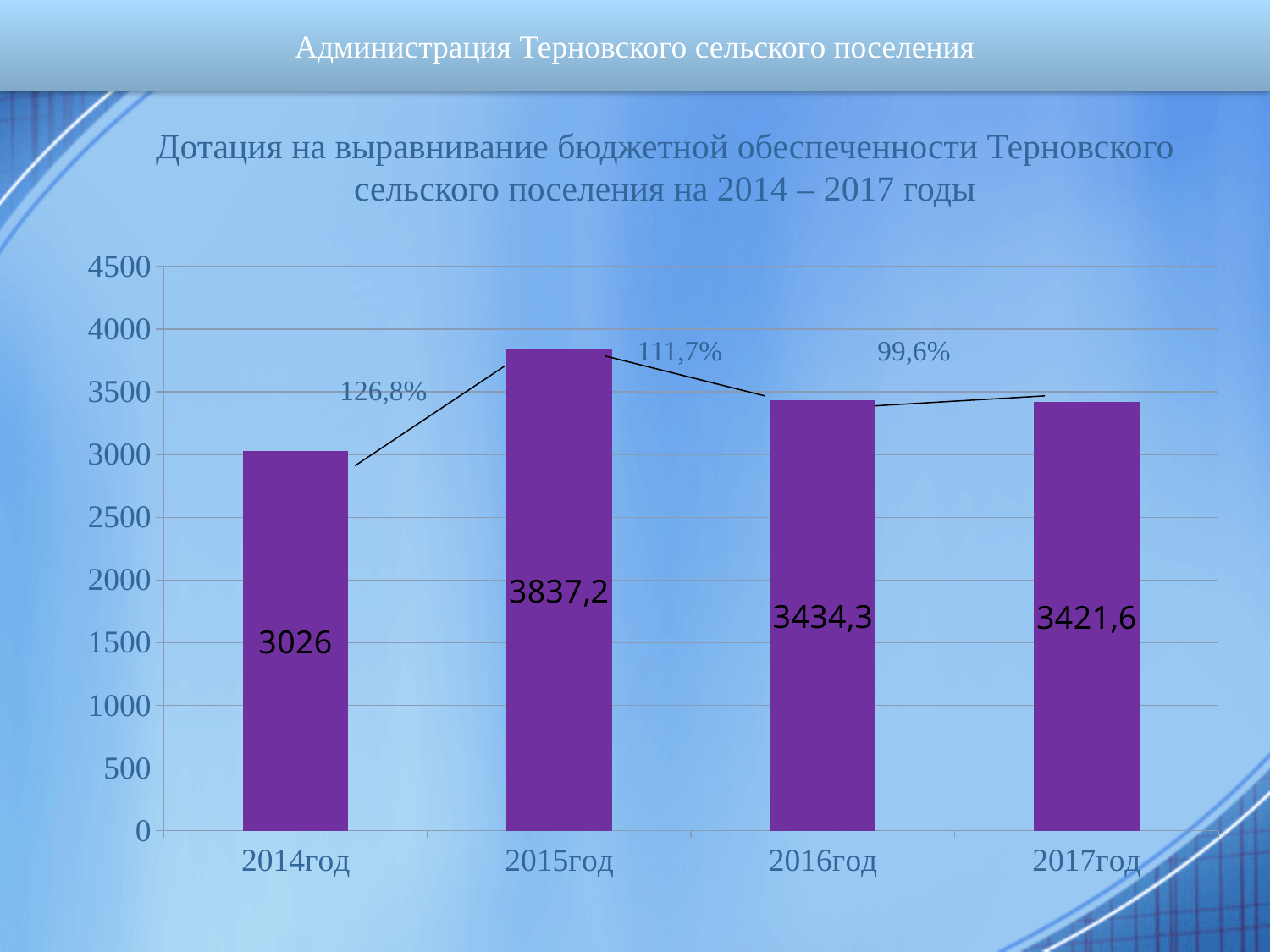
Which year has the highest value? 2015год Is the value for 2014год greater or less than 3500? less What is the difference between the values for 2015год and 2014год? 811,2 What is the value for 2016год? 3434,3 Which is larger, the value for 2015год or the value for 2016год? 2015год What is the value for 2015год? 3837,2 Which year has the lowest value? 2014год What kind of chart is shown on the slide? bar chart How many years are shown on the x axis? 4 What is the value for 2017год? 3421,6 What is the value for 2014год? 3026 What percentage label is shown between 2014год and 2015год? 126,8%